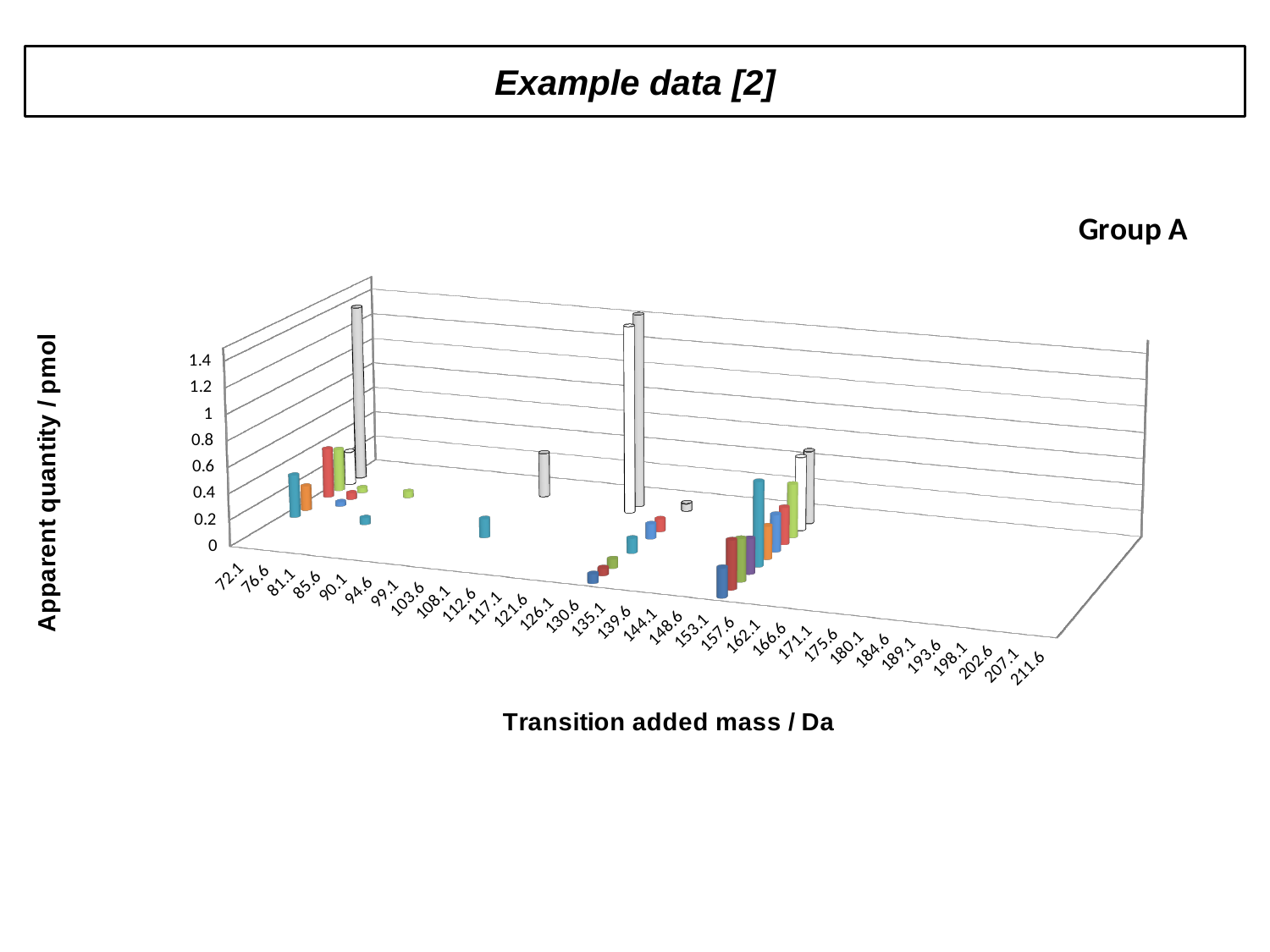
What is the title of the chart? Group A What is the label of the vertical axis? Apparent quantity / pmol What is the first category label on the x axis? 72.1 How many categories are labelled along the x axis? 32 What kind of chart is shown on the slide? bar chart What is the step between consecutive tick values on the vertical axis? 0.2 Is the value of the front bar at 72.1 greater or less than 1? less What is the highest tick value shown on the vertical axis? 1.4 What is the last category label on the x axis? 211.6